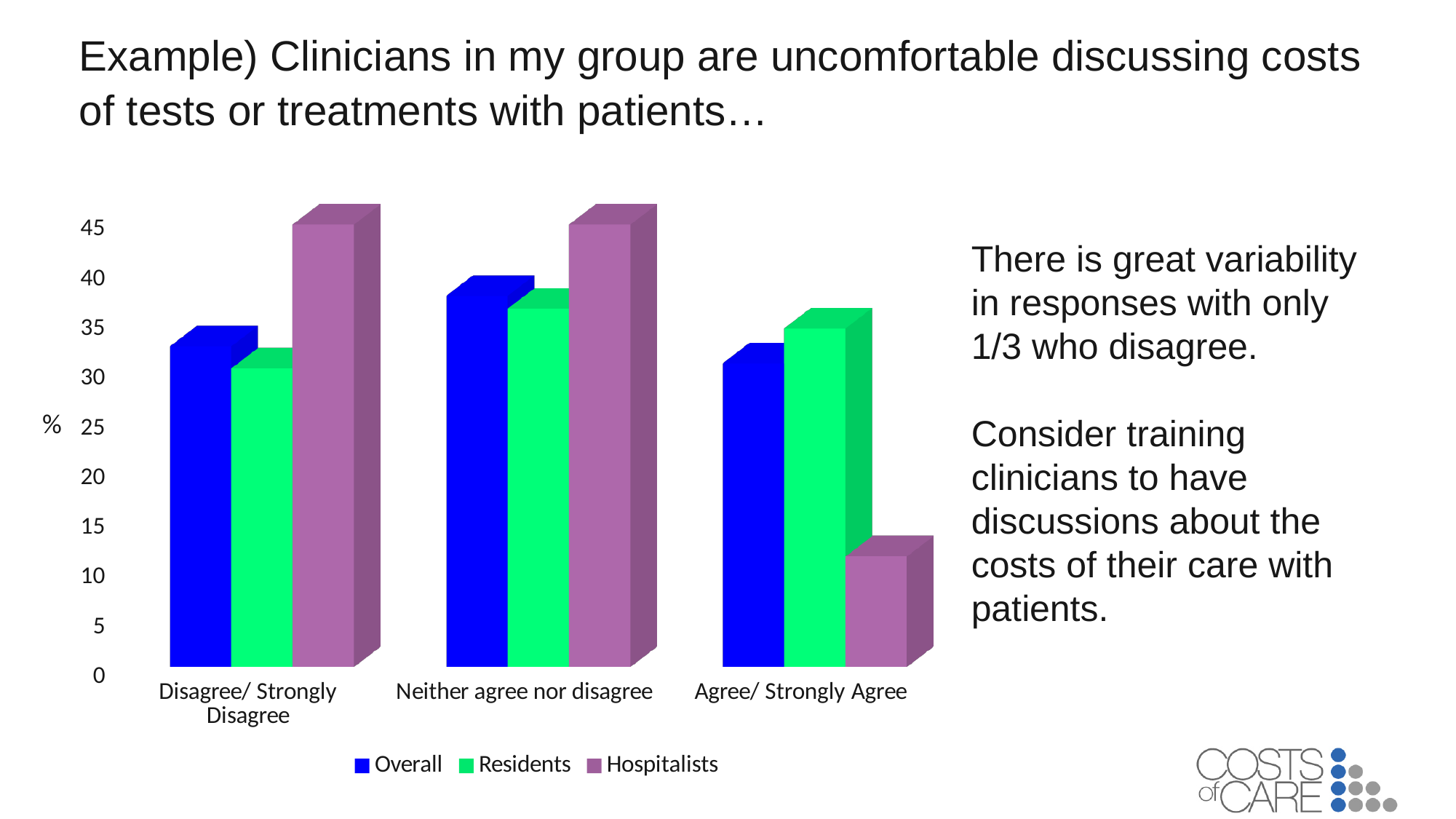
What kind of chart is shown on the slide? bar chart Which series are listed in the legend? Overall, Residents, Hospitalists Is the Hospitalists value for Disagree/ Strongly Disagree greater or less than 40? greater How many response categories are shown on the x axis? 3 How many series does the legend list? 3 Is the Hospitalists value for Agree/ Strongly Agree greater or less than 15? less For the Hospitalists series, which category has the lowest value? Agree/ Strongly Agree For Disagree/ Strongly Disagree, which is larger: the Hospitalists value or the Residents value? Hospitalists Is the Overall value for Neither agree nor disagree greater or less than 35? greater What label is shown on the vertical axis? % For Agree/ Strongly Agree, which is larger: the Residents value or the Hospitalists value? Residents